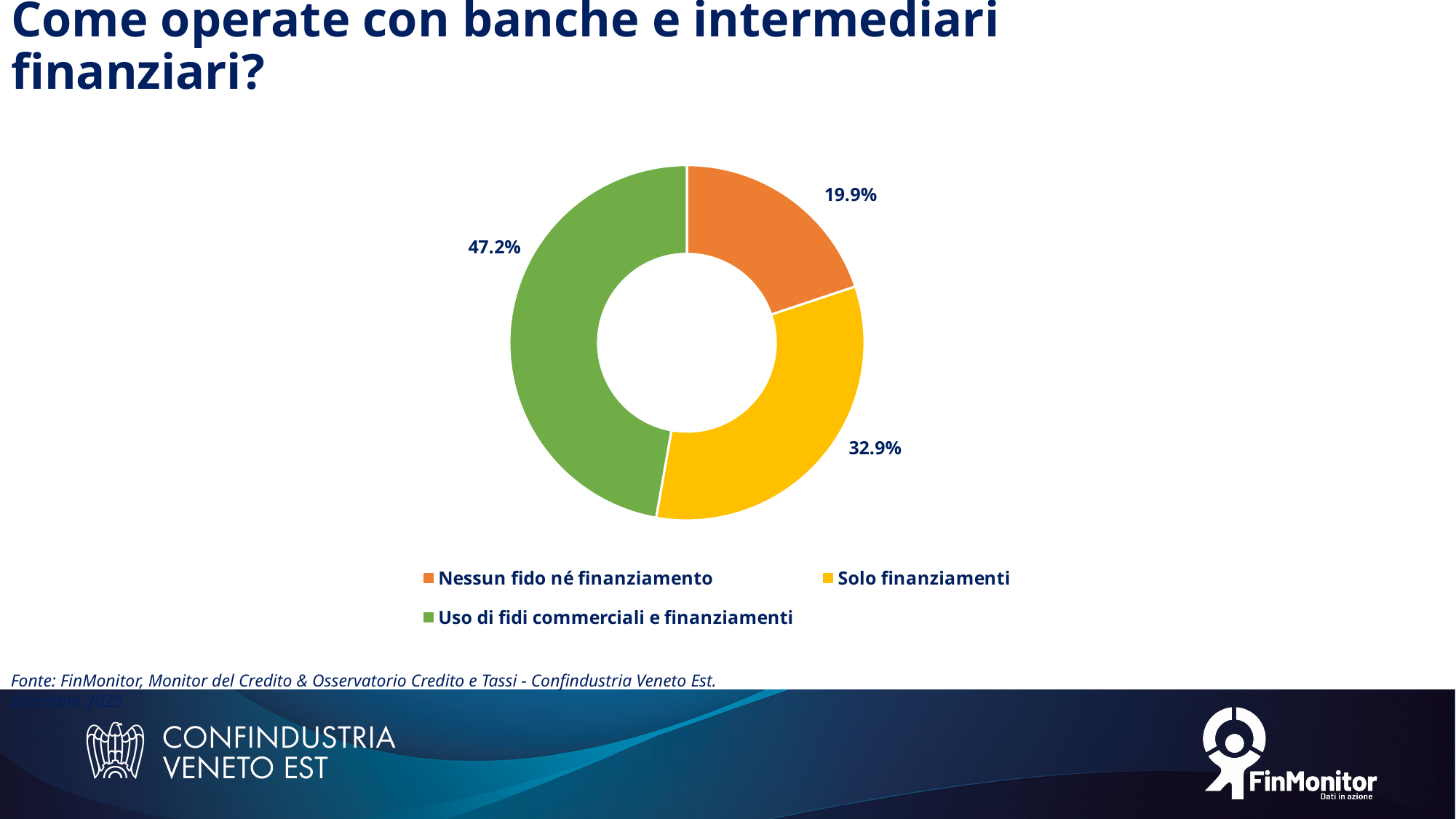
What is the difference in percentage points between "Solo finanziamenti" and "Nessun fido né finanziamento"? 13.0 What share of respondents answered "Nessun fido né finanziamento"? 19.9% Which category has the smallest share of the pie? Nessun fido né finanziamento What share of respondents answered "Solo finanziamenti"? 32.9% What kind of chart is shown on the slide? Pie chart (doughnut) Which category has the largest share of the pie? Uso di fidi commerciali e finanziamenti What share of respondents answered "Uso di fidi commerciali e finanziamenti"? 47.2% How many categories does the chart show? 3 What is the difference in percentage points between "Uso di fidi commerciali e finanziamenti" and "Solo finanziamenti"? 14.3 Which is larger: the share for "Solo finanziamenti" or for "Nessun fido né finanziamento"? Solo finanziamenti What is the title of the slide containing the chart? Come operate con banche e intermediari finanziari? What colour represents "Solo finanziamenti" in the chart? Yellow